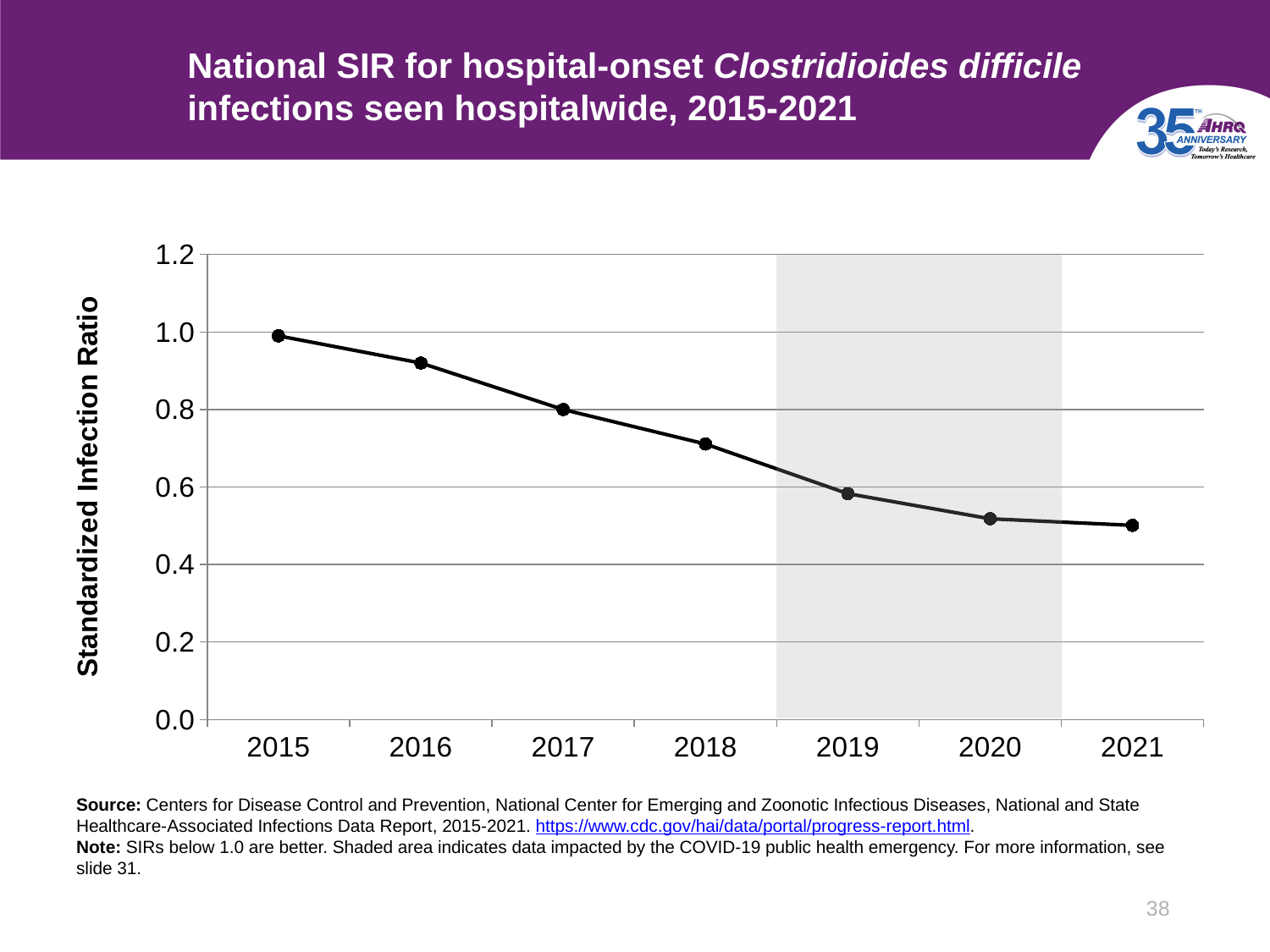
What kind of chart is shown on the slide? Line chart Do the SIR values rise or fall from 2015 to 2021? Fall How many data points are plotted on the line? 7 Is the value for 2021 greater or less than 0.6? less Is the value for 2018 greater or less than 0.6? greater Which year has the highest Standardized Infection Ratio? 2015 Is the value for 2019 greater or less than 0.8? less Which years fall within the shaded area of the chart? 2019 and 2020 Which year has the larger SIR, 2017 or 2020? 2017 What is the label on the vertical axis? Standardized Infection Ratio